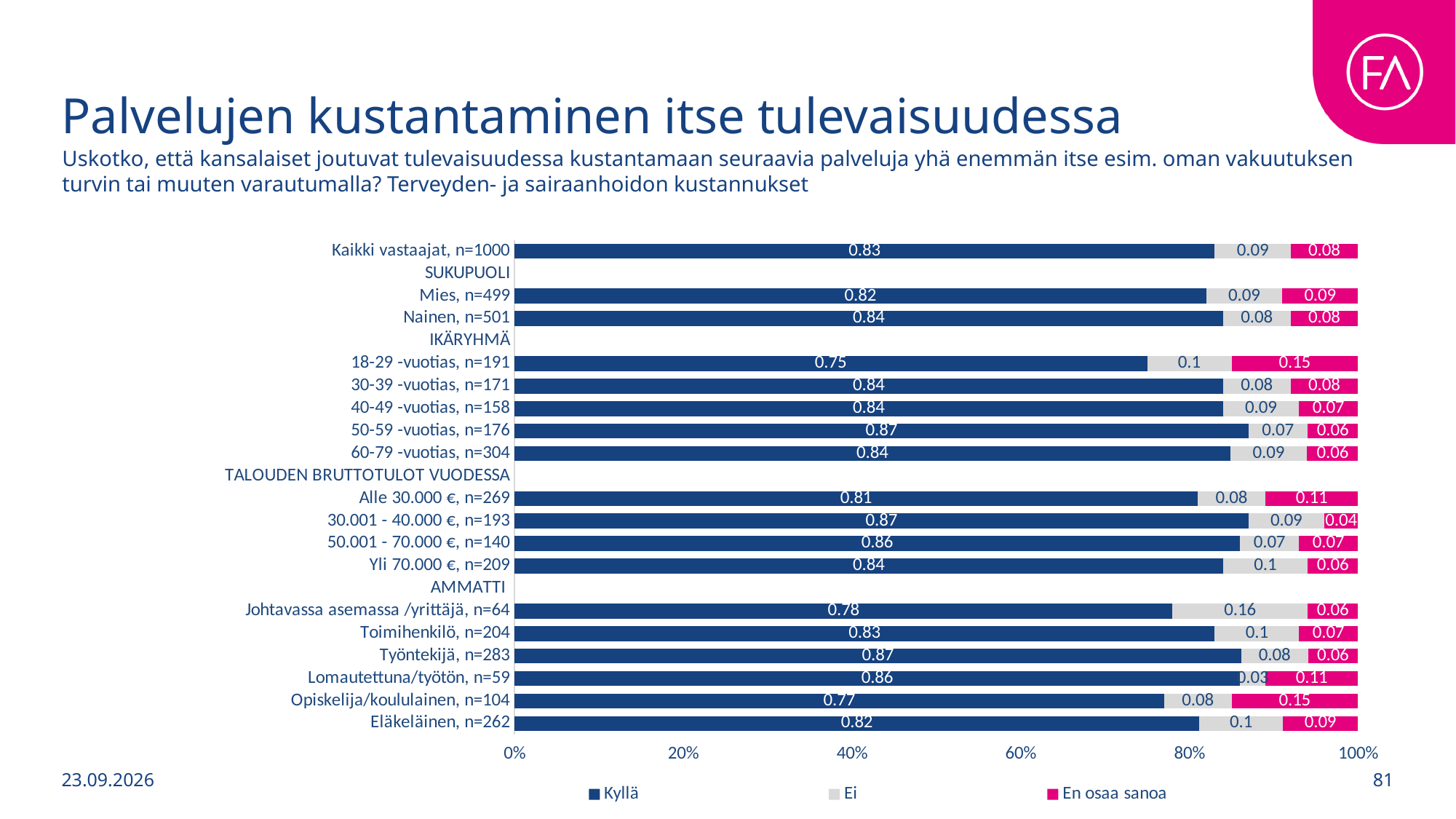
Which category has the highest Ei value? Johtavassa asemassa /yrittäjä, n=64 Which category has the lowest Kyllä value? 18-29 -vuotias, n=191 What is the En osaa sanoa value for 18-29 -vuotias, n=191? 0.15 How many series does the legend list? 3 What kind of chart is shown on the slide? Stacked bar chart Which has a larger Ei value: Johtavassa asemassa /yrittäjä, n=64 or Toimihenkilö, n=204? Johtavassa asemassa /yrittäjä, n=64 Which category has the lowest Ei value? Lomautettuna/työtön, n=59 What is the Kyllä value for Kaikki vastaajat, n=1000? 0.83 What is the Ei value for Johtavassa asemassa /yrittäjä, n=64? 0.16 What is the difference between the Kyllä values for 50-59 -vuotias, n=176 and 18-29 -vuotias, n=191? 0.12 Which legend entry is shown in pink? En osaa sanoa Is the Kyllä value for 18-29 -vuotias, n=191 greater or less than 80%? less